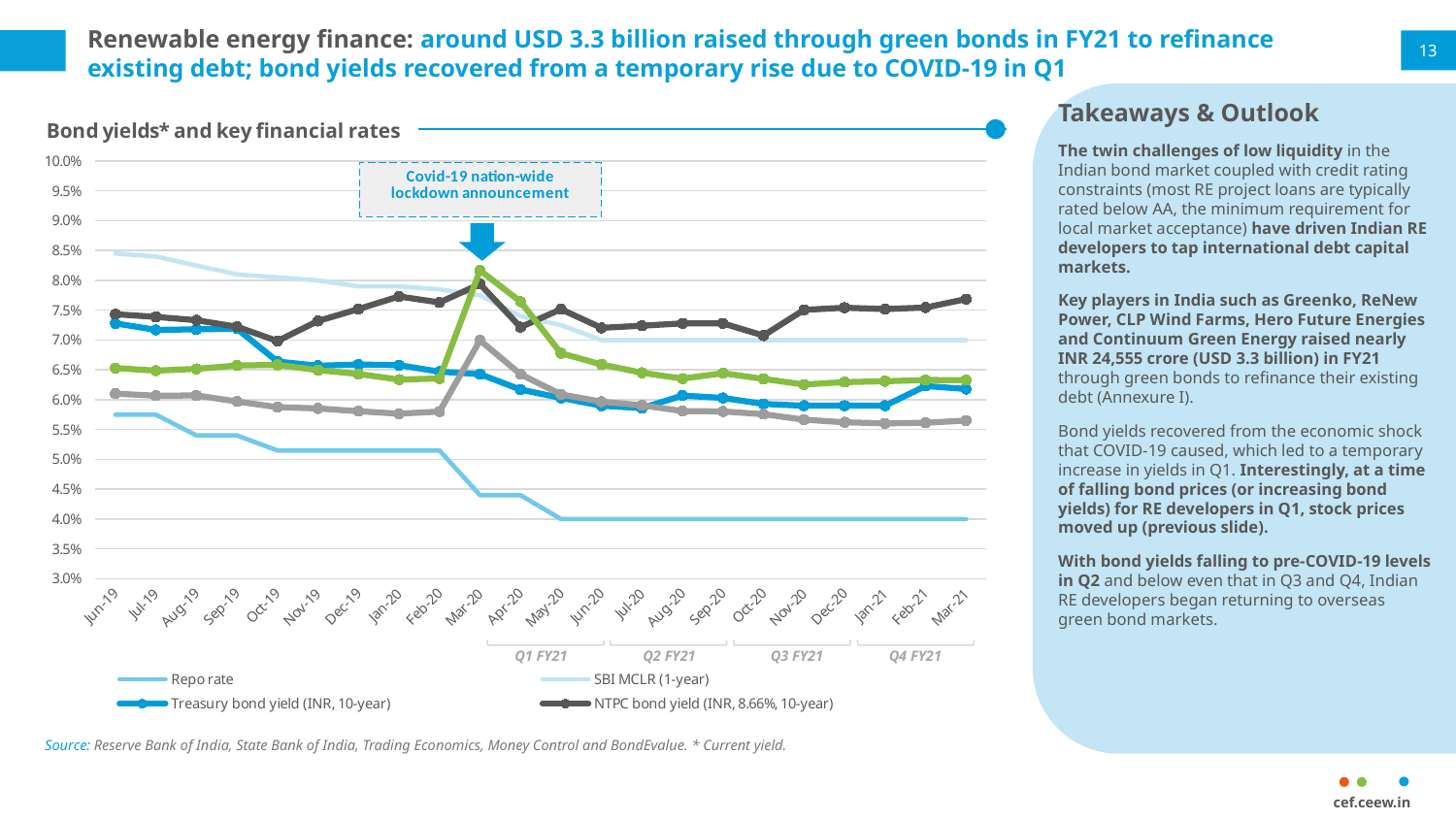
Is the NTPC bond yield in Mar-20 greater or less than 7.5%? greater How many months are shown on the x axis of the chart? 22 Is the SBI MCLR (1-year) in Jun-19 greater or less than 8.0%? greater Which series has the highest value in Jun-19? SBI MCLR (1-year) Which month does the 'Covid-19 nation-wide lockdown announcement' annotation point to? Mar-20 What is the Repo rate in Mar-21? 4.0% How many series does the chart legend list? 4 What kind of chart is shown on the slide? Line chart In Mar-21, which is higher: the NTPC bond yield or the Treasury bond yield? NTPC bond yield Does the Repo rate rise or fall from Jun-19 to Mar-21? Fall Which series has the lowest value in Mar-21? Repo rate Is the Treasury bond yield (INR, 10-year) in Mar-21 greater or less than 6.5%? less